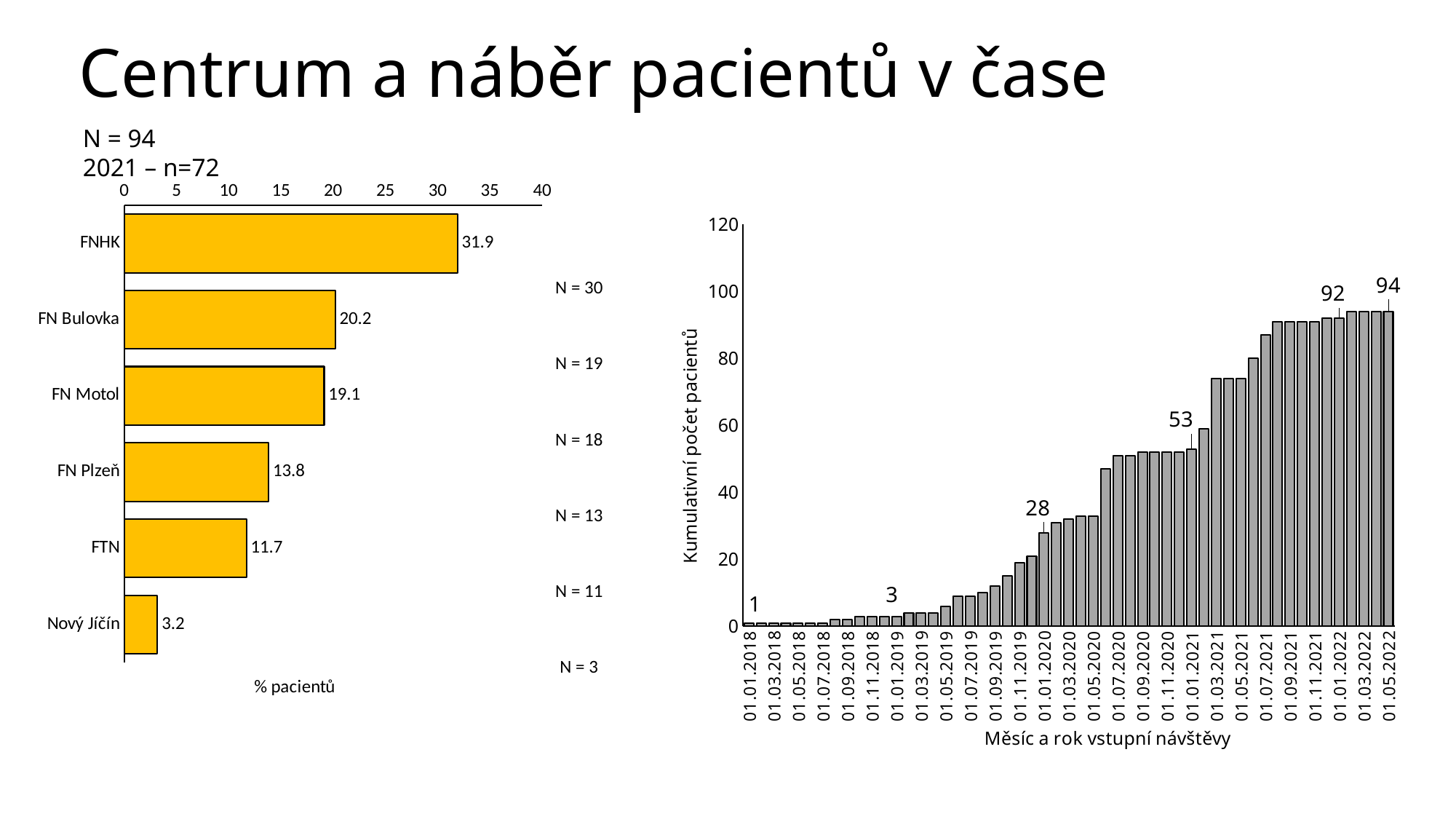
In the left chart, what is the difference between the values for FN Bulovka and FN Motol? 1.1 In the left chart, which is larger, the value for FTN or the value for FN Plzeň? FN Plzeň How many centres are shown in the left chart? 6 In the left chart, what is the value for FNHK? 31.9 In the right chart, what is the cumulative number of patients labelled at 01.01.2021? 53 What kind of chart is the left chart? Bar chart In the right chart, what is the cumulative number of patients labelled at 01.05.2022? 94 In the left chart, which centre has the lowest percentage of patients? Nový Jíčín In the left chart, what is the value for FN Plzeň? 13.8 In the right chart, do the values rise or fall along the x axis? Rise In the left chart, which centre has the highest percentage of patients? FNHK What is the y-axis label of the right chart? Kumulativní počet pacientů